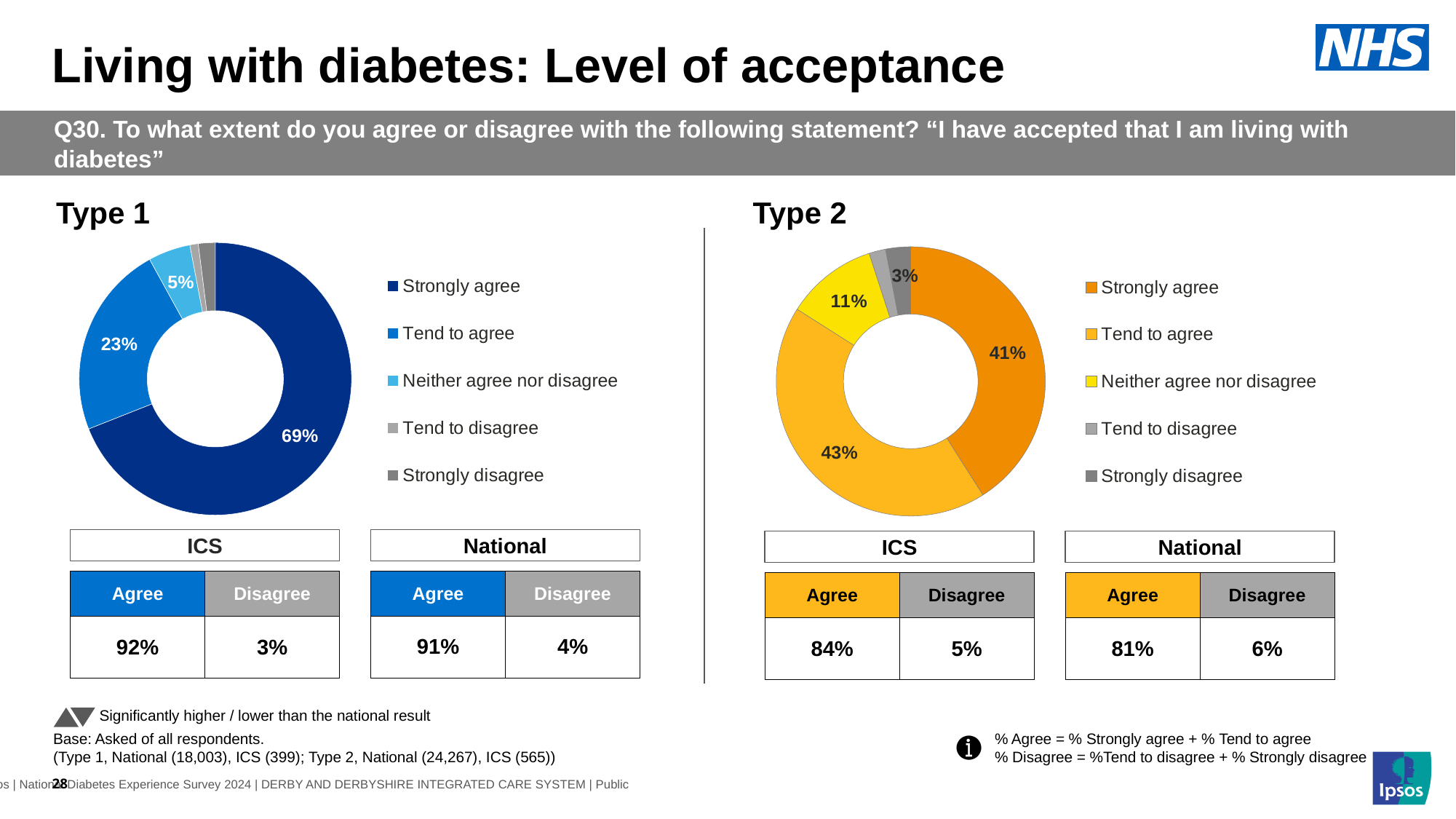
In the Type 1 chart, what percentage of respondents tend to agree? 23% In the Type 2 chart, what percentage neither agree nor disagree? 11% What kind of chart is used for Type 1? Doughnut (pie) chart In the Type 1 chart, what is the difference between the Strongly agree and Tend to agree shares? 46% How many response categories does the legend of the Type 2 chart list? 5 In the Type 2 chart, what percentage of respondents tend to agree? 43% In the Type 1 chart, what percentage neither agree nor disagree? 5% In the Type 2 chart, which response category has the largest share? Tend to agree In the Type 2 chart, what percentage of respondents strongly agree? 41% In the Type 1 chart, which response category has the largest share? Strongly agree Which chart has the larger Strongly agree share, Type 1 or Type 2? Type 1 In the Type 1 chart, what percentage of respondents strongly agree? 69%